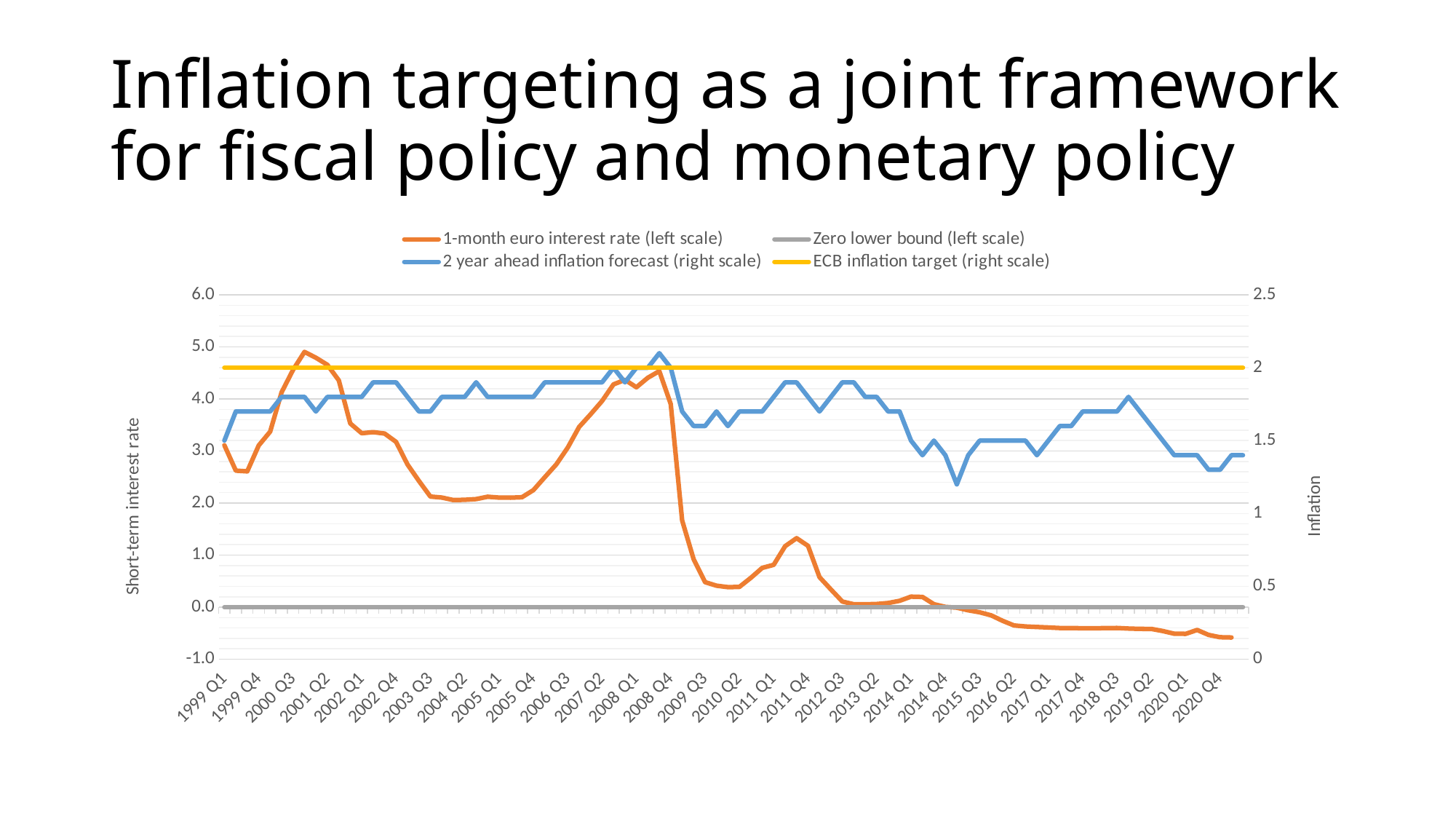
Is the 1-month euro interest rate in 2009 Q3 greater or less than 1.0? less At what level on the left scale is the Zero lower bound line drawn? 0.0 Is the 2 year ahead inflation forecast in 2015 Q1 greater or less than 1.5 on the right scale? less Does the 1-month euro interest rate rise or fall between 2008 Q1 and 2009 Q3? Fall What is the title of the right vertical axis? Inflation What kind of chart is shown on the slide? Line chart Is the 1-month euro interest rate in 2020 Q4 greater or less than 0.0? less Which is larger, the 1-month euro interest rate in 2001 Q2 or in 2020 Q4? 2001 Q2 How many series does the legend list? 4 What is the title of the left vertical axis? Short-term interest rate At what level on the right scale is the ECB inflation target line drawn? 2